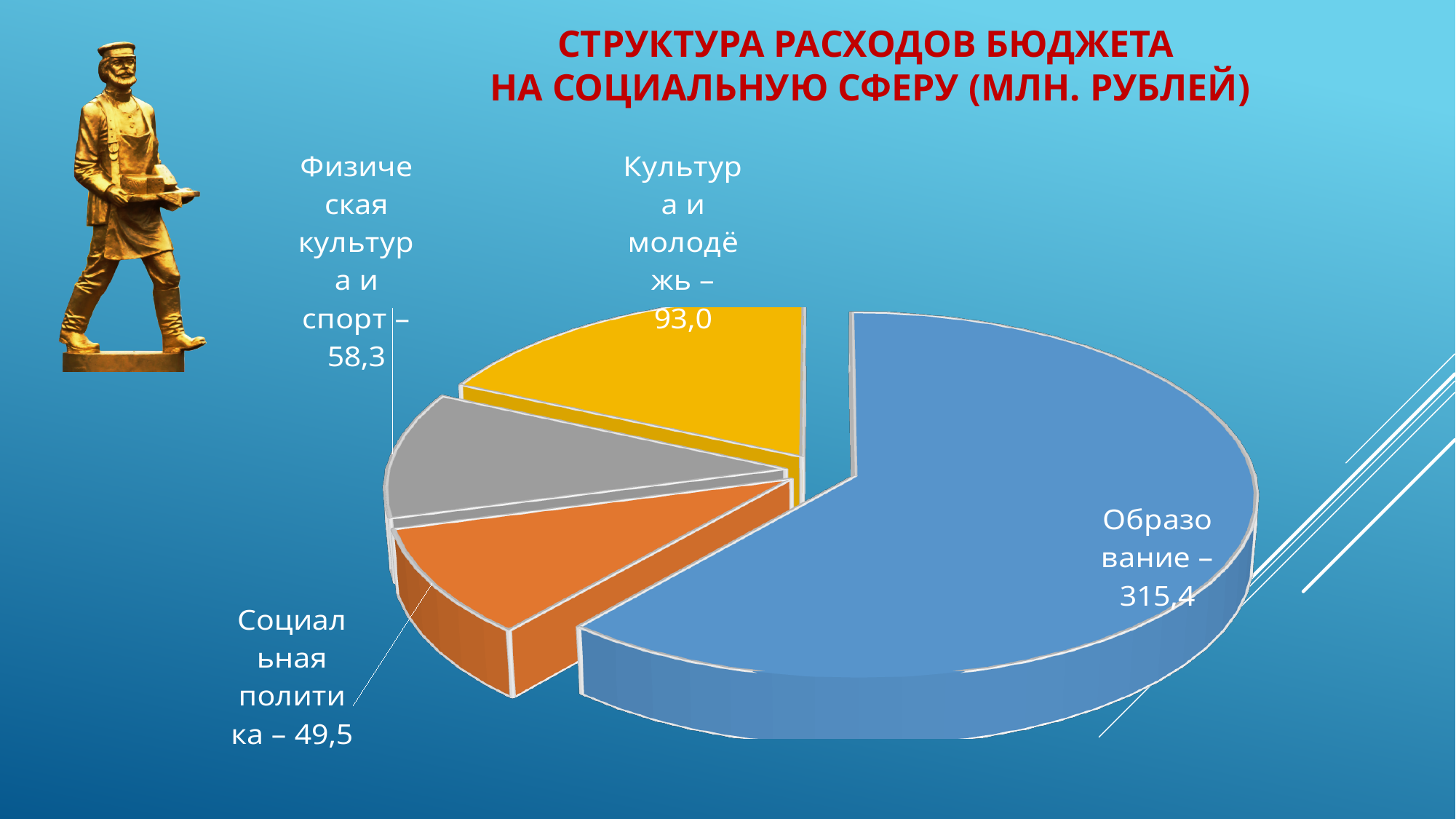
What is the value for Социальная политика? 49,5 Which category has the smallest share of the pie? Социальная политика Which category has the largest share of the pie? Образование What is the total of all slices in the pie chart? 516,2 What unit is stated in the chart title? млн. рублей What is the value for Образование? 315,4 Which is larger: Физическая культура и спорт or Социальная политика? Физическая культура и спорт What is the value for Культура и молодёжь? 93,0 What is the value for Физическая культура и спорт? 58,3 What is the difference between the values for Образование and Культура и молодёжь? 222,4 What type of chart is shown on the slide? pie chart How many slices does the pie chart have? 4